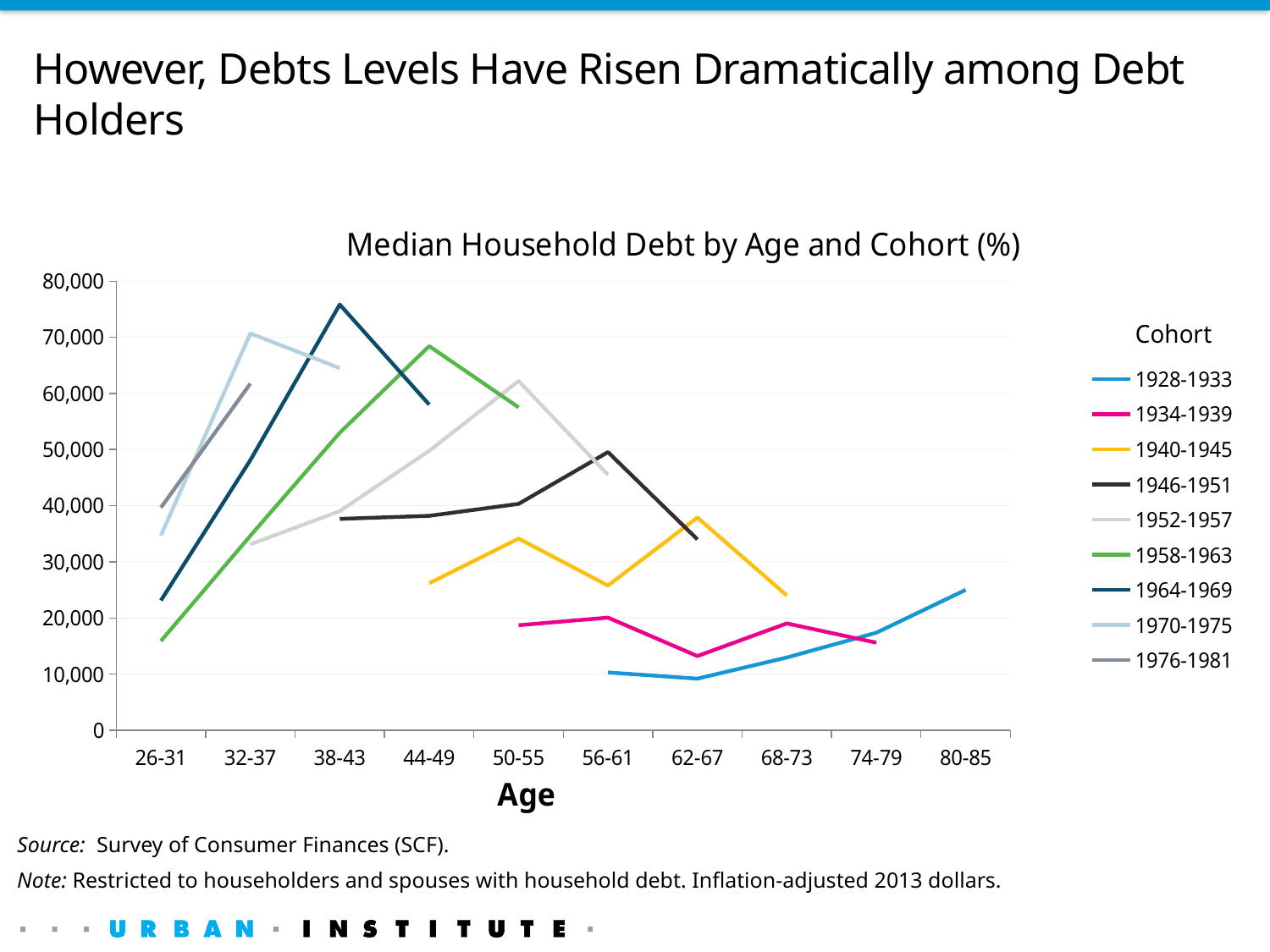
At age 32-37, which cohort has the higher median debt: 1970-1975 or 1958-1963? 1970-1975 Which cohort has the lowest median debt at age 56-61? 1928-1933 How many age groups are shown along the x axis? 10 Does the 1928-1933 cohort's median debt rise or fall from age 62-67 to age 80-85? Rises What is the title of the chart? Median Household Debt by Age and Cohort (%) Is the value for the 1958-1963 cohort at age 44-49 greater or less than 60,000? greater Which cohort reaches the highest median household debt on the chart? 1964-1969 What is the label of the x axis? Age How many cohorts does the legend list? 9 What kind of chart is shown on the slide? Line chart Is the value for the 1964-1969 cohort at age 38-43 greater or less than 70,000? greater